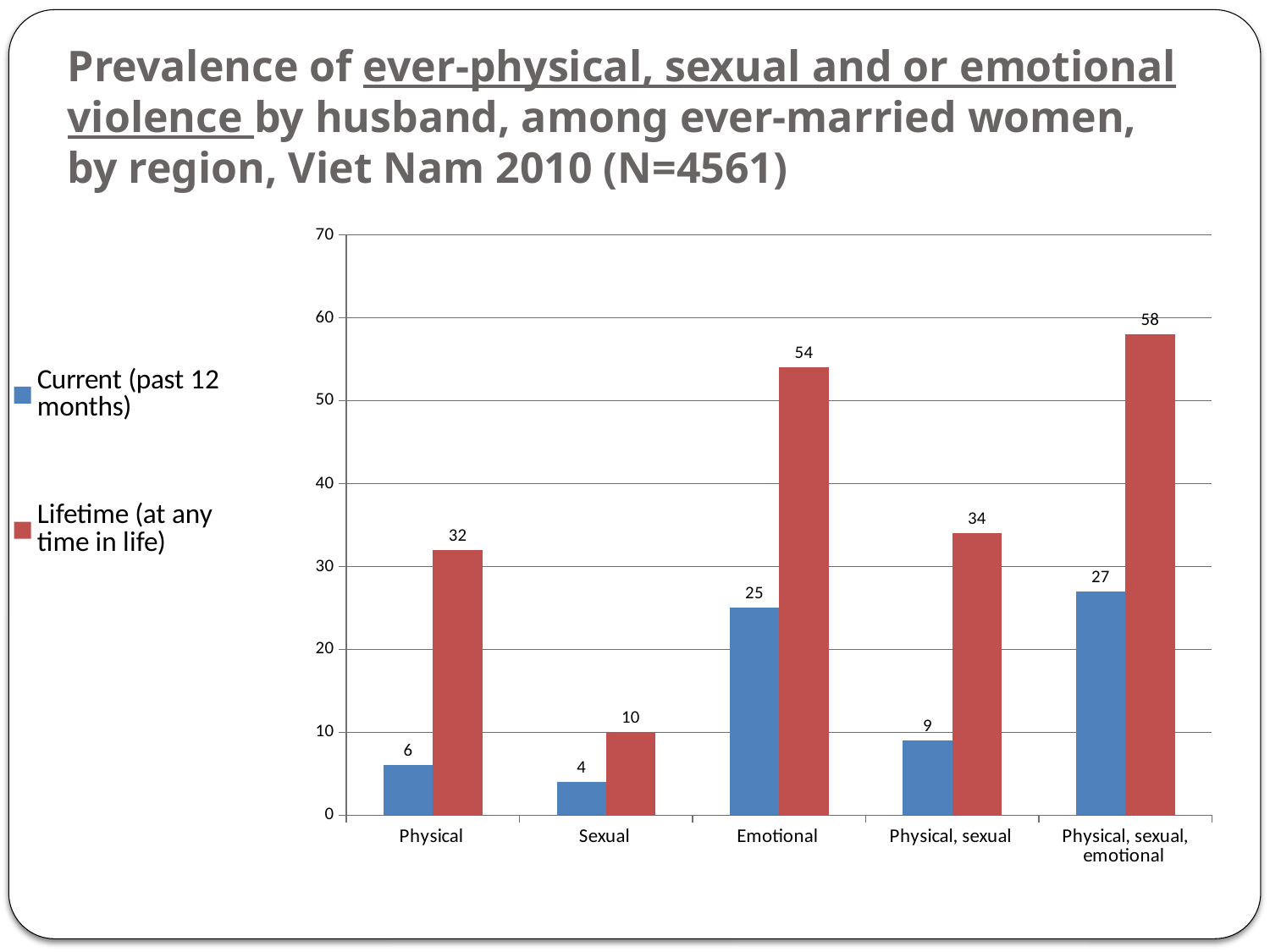
What is the Current (past 12 months) value for Physical, sexual, emotional violence? 27 Which category has the highest Lifetime (at any time in life) value? Physical, sexual, emotional What kind of chart is shown on the slide? bar chart Which category has the lowest Current (past 12 months) value? Sexual Which is larger: the Lifetime value for Physical violence or the Lifetime value for Physical, sexual violence? Physical, sexual What is the Lifetime (at any time in life) value for Emotional violence? 54 What is the difference between the Lifetime and Current values for Physical, sexual violence? 25 How many series does the legend list? 2 Which colour represents the Lifetime (at any time in life) series? red How many categories are shown on the x axis? 5 What is the Current (past 12 months) value for Physical violence? 6 Is the Lifetime (at any time in life) value for Physical, sexual, emotional violence greater or less than 50? greater